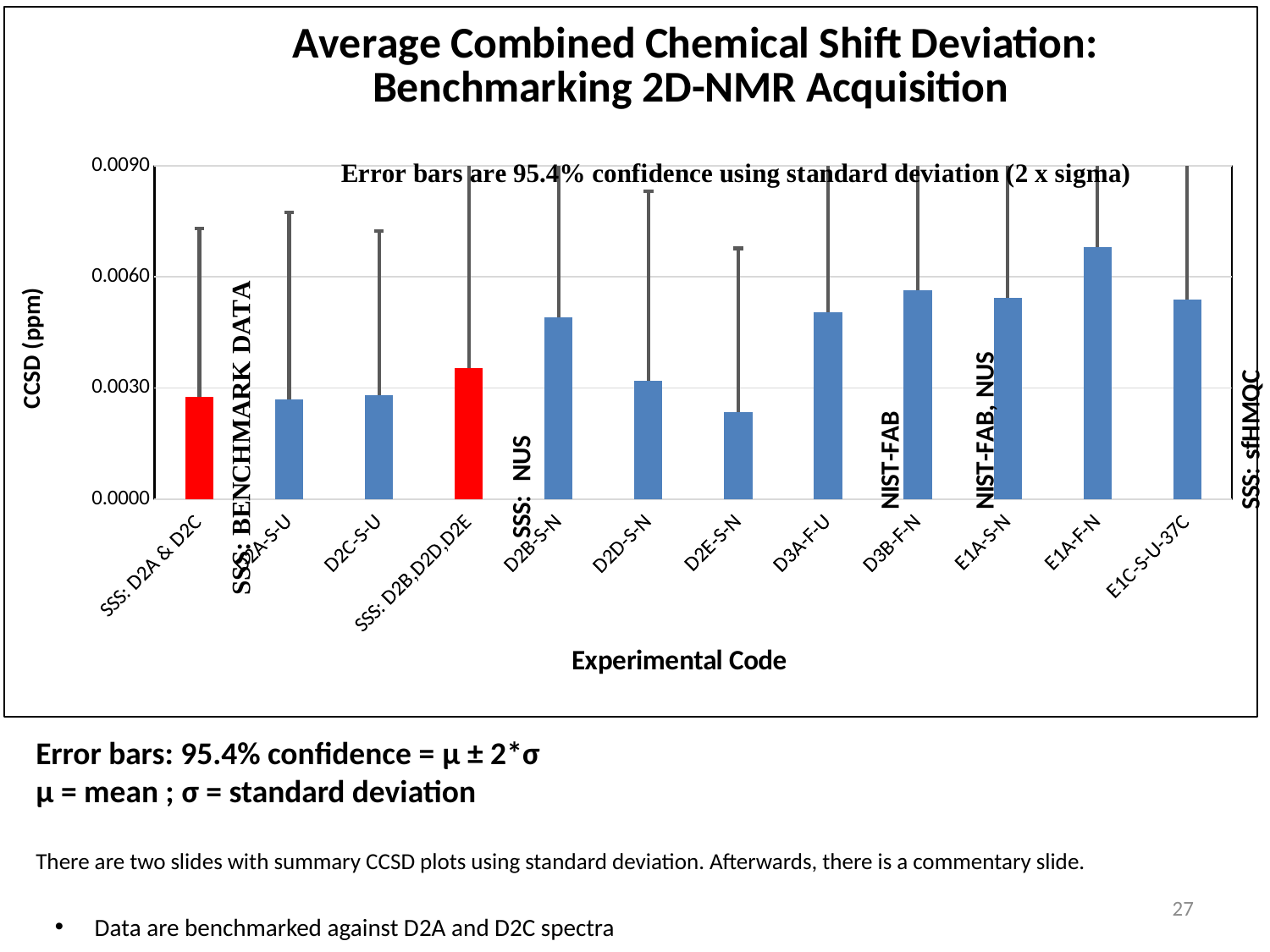
What kind of chart is shown on the slide? Bar chart Is the value for D2B-S-N greater or less than 0.0030? greater Which experimental code has the lowest average CCSD? D2E-S-N What is the label of the y axis of the chart? CCSD (ppm) Is the value for E1A-F-N greater or less than 0.0060? greater How many experimental codes (bars) are plotted in the chart? 12 Is the value for D2E-S-N greater or less than 0.0030? less Which has the larger value, D2B-S-N or D2D-S-N? D2B-S-N Which experimental code has the highest average CCSD? E1A-F-N Which has the larger value, E1A-F-N or D3A-F-U? E1A-F-N What is the label of the x axis of the chart? Experimental Code